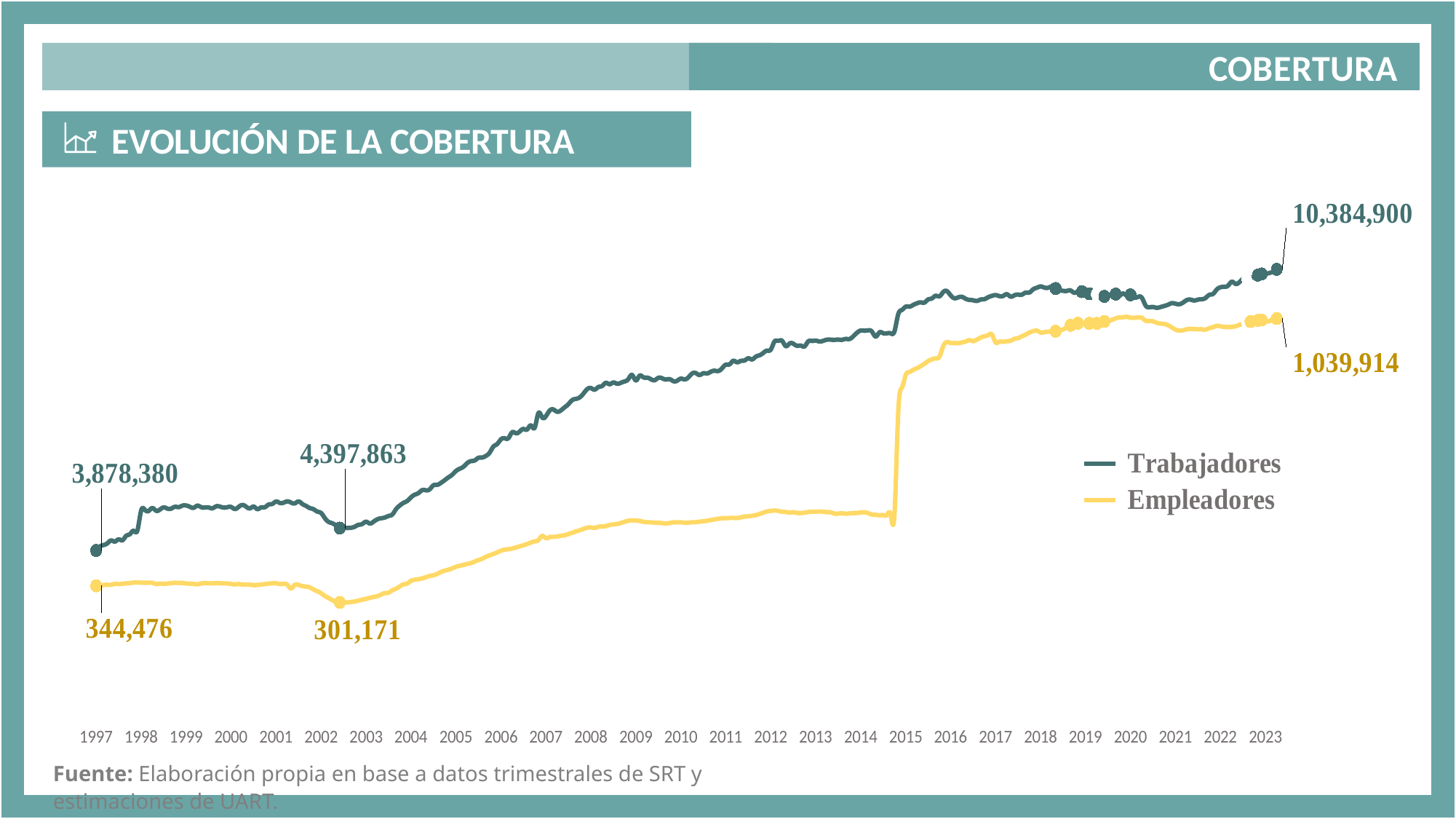
What is the difference between the last labelled Trabajadores value (10,384,900) and the first labelled Trabajadores value (3,878,380)? 6,506,520 How many series does the legend list? 2 What is the labelled value for Empleadores at the low point around 2002? 301,171 What is the last labelled value for Empleadores, at the end of the series in 2023? 1,039,914 What is the first labelled value for Empleadores, at the start of the series in 1997? 344,476 What is the last labelled value for Trabajadores, at the end of the series in 2023? 10,384,900 What is the labelled value for Trabajadores at the low point around 2002? 4,397,863 What is the first labelled value for Trabajadores, at the start of the series in 1997? 3,878,380 Overall, do the Trabajadores values rise or fall from 1997 to 2023? rise What is the title of the chart? EVOLUCIÓN DE LA COBERTURA What kind of chart is shown on the slide? line chart Which series has the higher values throughout the chart, Trabajadores or Empleadores? Trabajadores